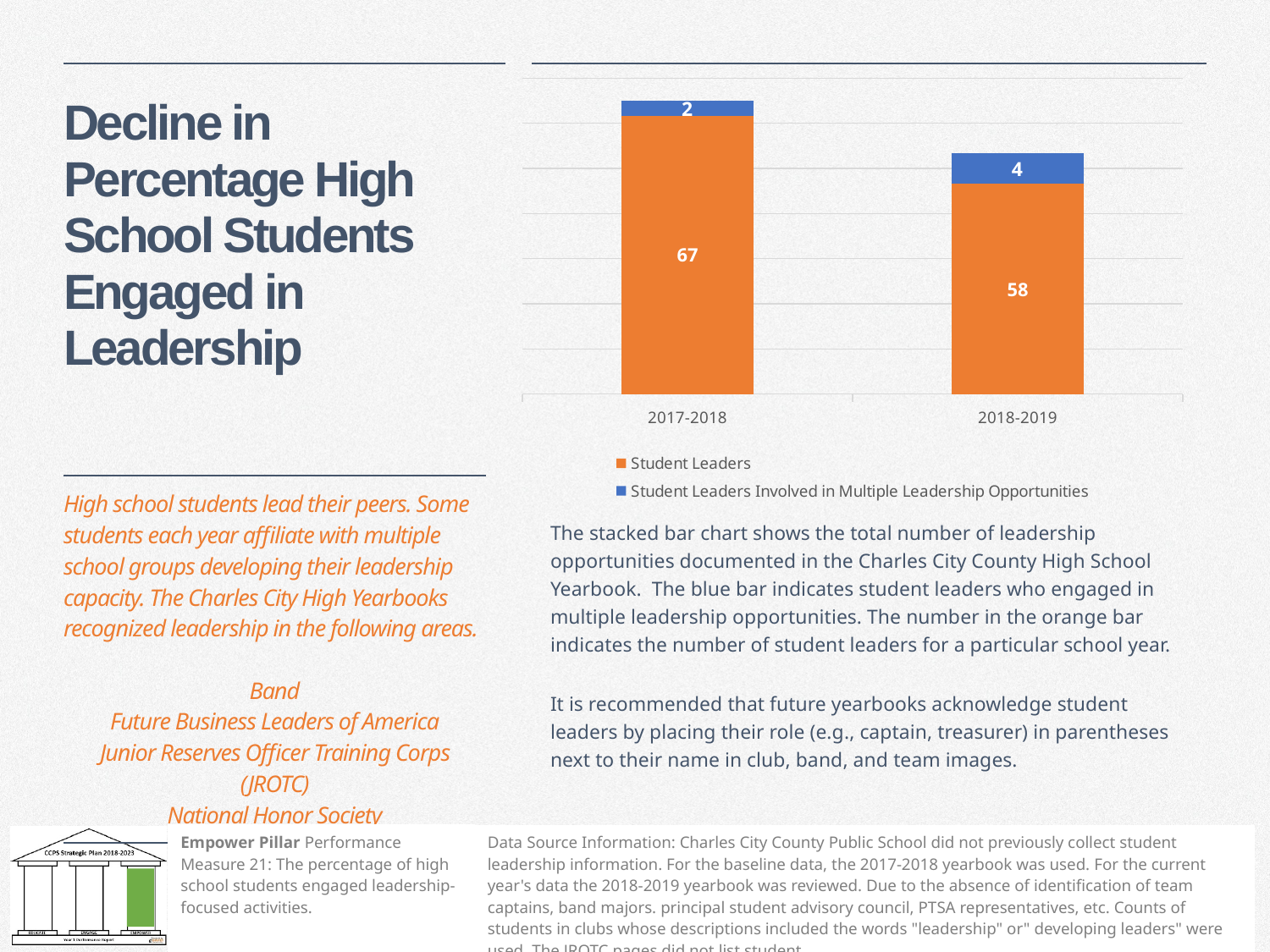
Which school year has the lower number of Student Leaders Involved in Multiple Leadership Opportunities? 2017-2018 What is the value for Student Leaders Involved in Multiple Leadership Opportunities in 2018-2019? 4 What is the total of the stacked bar for 2018-2019? 62 How many school years are shown on the x axis? 2 How many series does the legend list? 2 What is the difference in Student Leaders between 2017-2018 and 2018-2019? 9 What is the value for Student Leaders in 2018-2019? 58 What is the value for Student Leaders in 2017-2018? 67 What is the value for Student Leaders Involved in Multiple Leadership Opportunities in 2017-2018? 2 Which school year has the higher number of Student Leaders? 2017-2018 What is the total of the stacked bar for 2017-2018? 69 What kind of chart is shown on the slide? Stacked bar chart